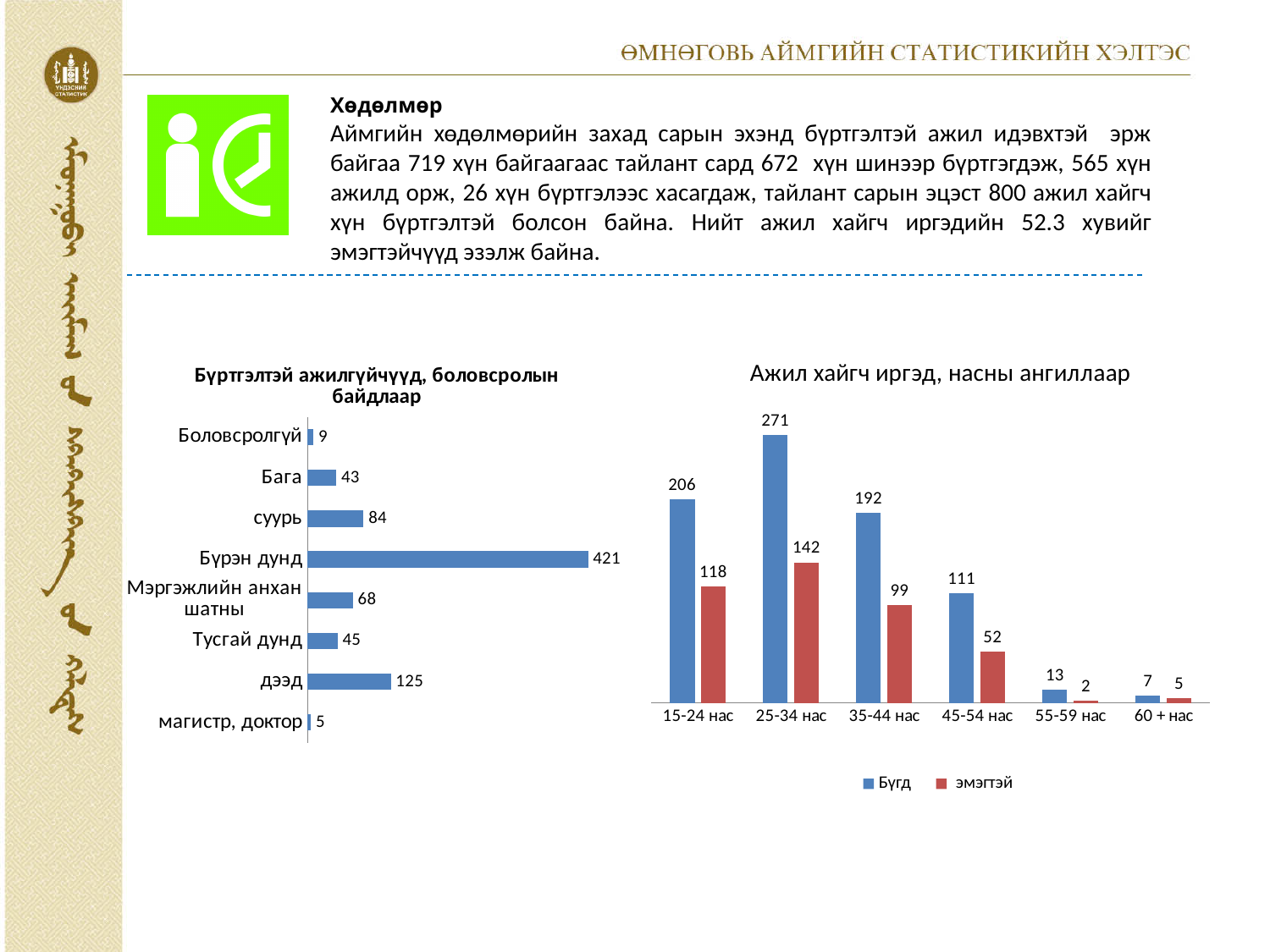
In the chart 'Бүртгэлтэй ажилгүйчүүд, боловсролын байдлаар', how many categories are shown? 8 In the chart 'Ажил хайгч иргэд, насны ангиллаар', is the Бүгд value for 35-44 нас larger or the эмэгтэй value for 25-34 нас? Бүгд value for 35-44 нас In the chart 'Ажил хайгч иргэд, насны ангиллаар', how many series does the legend list? 2 In the chart 'Ажил хайгч иргэд, насны ангиллаар', what is the difference between Бүгд and эмэгтэй for 15-24 нас? 88 In the chart 'Бүртгэлтэй ажилгүйчүүд, боловсролын байдлаар', what is the difference between дээд and суурь? 41 In the chart 'Ажил хайгч иргэд, насны ангиллаар', which age group has the highest Бүгд value? 25-34 нас In the chart 'Ажил хайгч иргэд, насны ангиллаар', what is the Бүгд value for 25-34 нас? 271 In the chart 'Бүртгэлтэй ажилгүйчүүд, боловсролын байдлаар', which category has the lowest value? магистр, доктор In the chart 'Ажил хайгч иргэд, насны ангиллаар', do the Бүгд values rise or fall from 25-34 нас to 60 + нас? Fall What kind of chart is 'Бүртгэлтэй ажилгүйчүүд, боловсролын байдлаар'? Bar chart In the chart 'Ажил хайгч иргэд, насны ангиллаар', what is the эмэгтэй value for 45-54 нас? 52 In the chart 'Бүртгэлтэй ажилгүйчүүд, боловсролын байдлаар', what is the value for Бүрэн дунд? 421